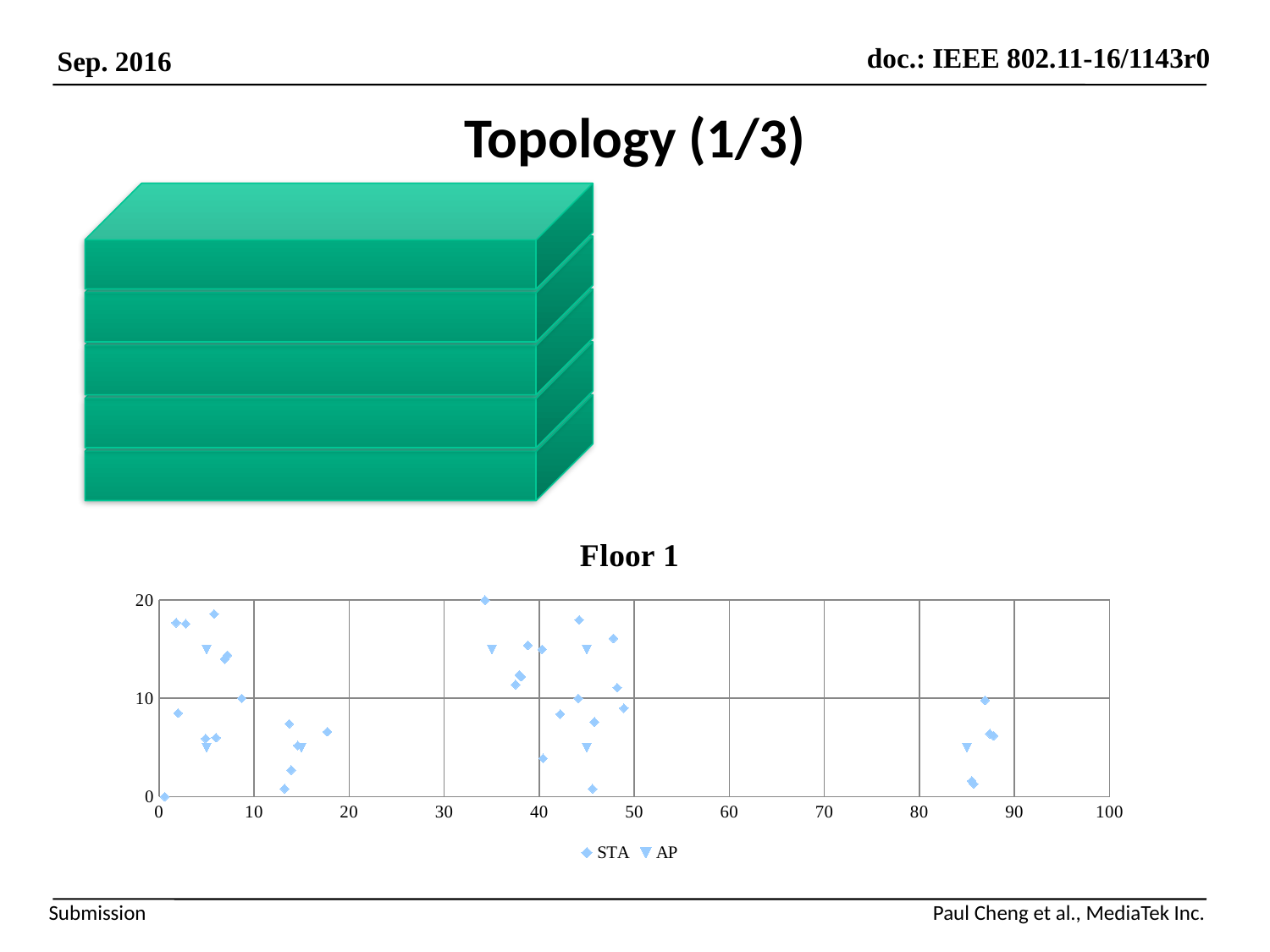
Which series in the "Floor 1" chart is plotted with triangle markers? AP What are the two series named in the legend of the "Floor 1" chart? STA and AP What kind of chart is shown under the title "Floor 1"? scatter chart What is the highest value shown on the y axis of the "Floor 1" chart? 20 What is the highest value shown on the x axis of the "Floor 1" chart? 100 How many series does the legend of the "Floor 1" chart list? 2